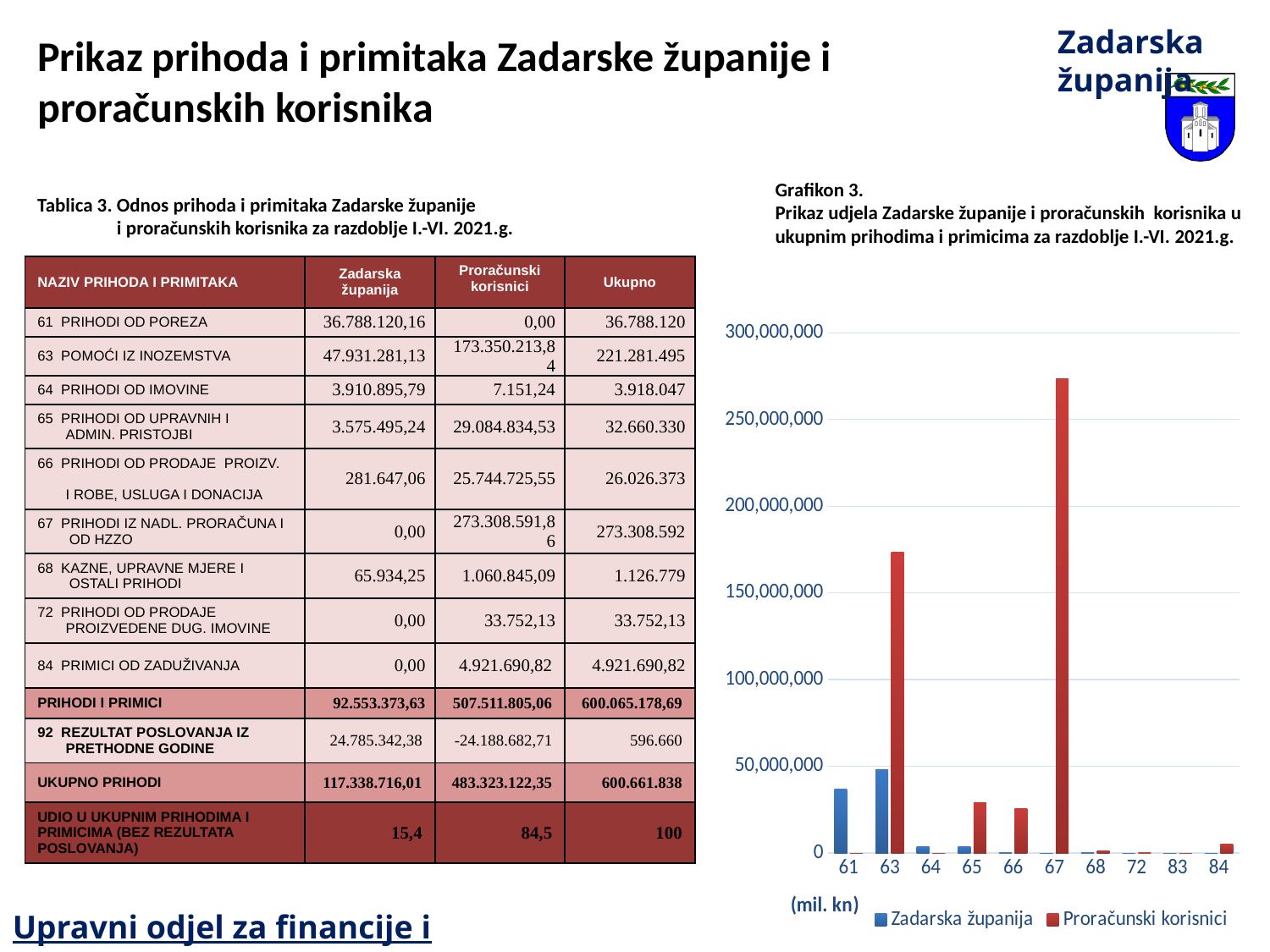
In Grafikon 3, which category has the highest value for Zadarska županija? 63 What kind of chart is Grafikon 3? bar chart In Grafikon 3, which category has the highest value for Proračunski korisnici? 67 In Grafikon 3, at category 63, which series has the larger value: Zadarska županija or Proračunski korisnici? Proračunski korisnici In Grafikon 3, is the value for Proračunski korisnici at category 63 greater or less than 150,000,000? greater In Grafikon 3, at category 61, which series has the larger value: Zadarska županija or Proračunski korisnici? Zadarska županija In Grafikon 3, is the value for Zadarska županija at category 61 greater or less than 50,000,000? less How many series does the legend of Grafikon 3 list? 2 What colour represents Proračunski korisnici in Grafikon 3? red In Grafikon 3, for Proračunski korisnici, which is larger: the value at 63 or the value at 67? 67 How many categories are shown on the x axis of Grafikon 3? 10 In Grafikon 3, is the value for Proračunski korisnici at category 67 greater or less than 250,000,000? greater